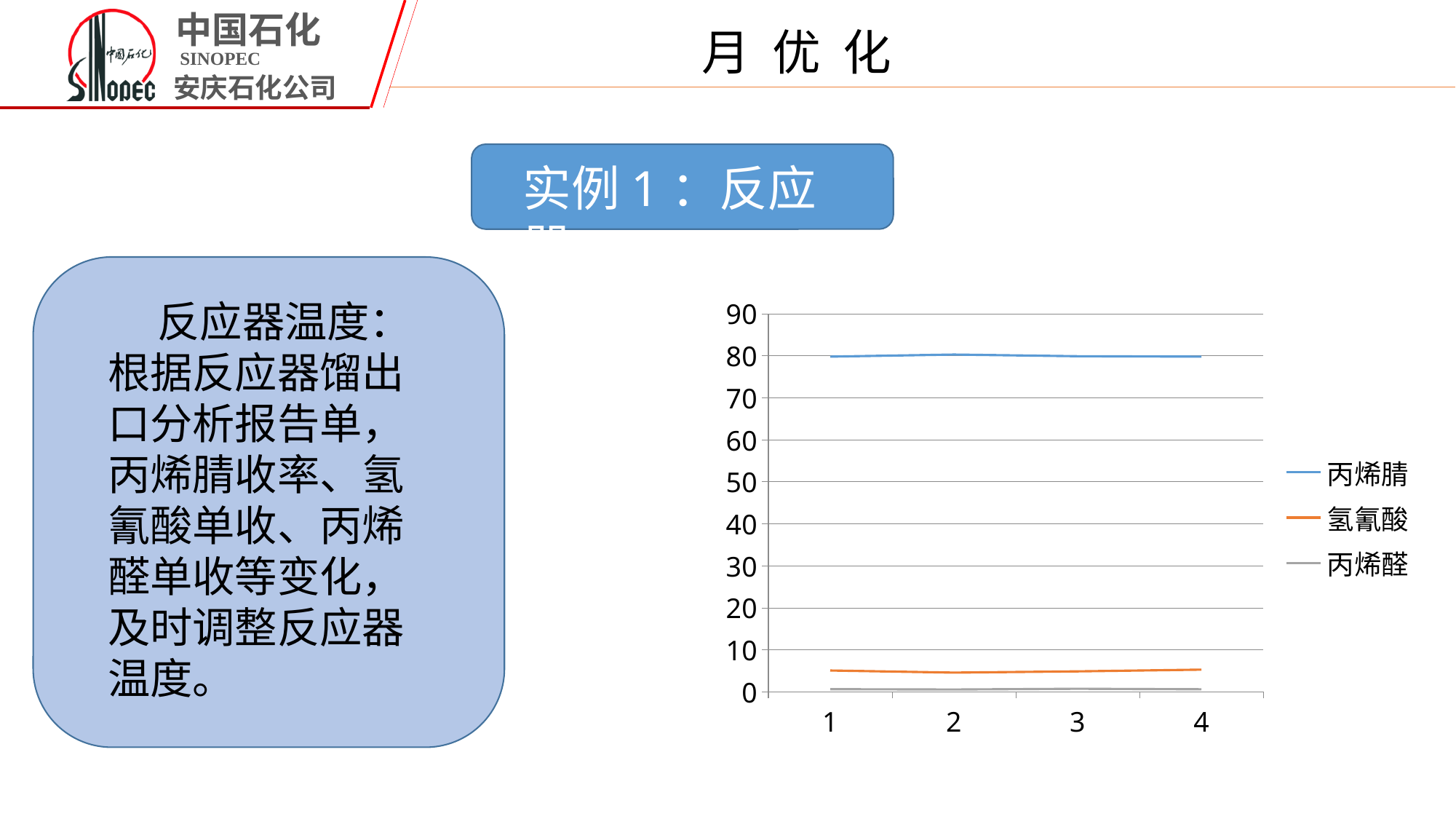
What is the highest value shown on the chart's y axis? 90 Which is larger at x = 3, the value for 氢氰酸 or the value for 丙烯醛? 氢氰酸 Which series has the lowest values on the chart? 丙烯醛 Which series has the highest values on the chart? 丙烯腈 How many points are plotted along the x axis for each series? 4 Is the value for 丙烯腈 at x = 2 greater or less than 90? less Which is larger at x = 2, the value for 丙烯腈 or the value for 氢氰酸? 丙烯腈 What kind of chart is shown on the slide? line chart What colour is the line for 氢氰酸 in the chart? orange Is the value for 丙烯腈 at x = 1 greater or less than 70? greater Is the value for 氢氰酸 at x = 4 greater or less than 10? less How many series does the chart legend list? 3